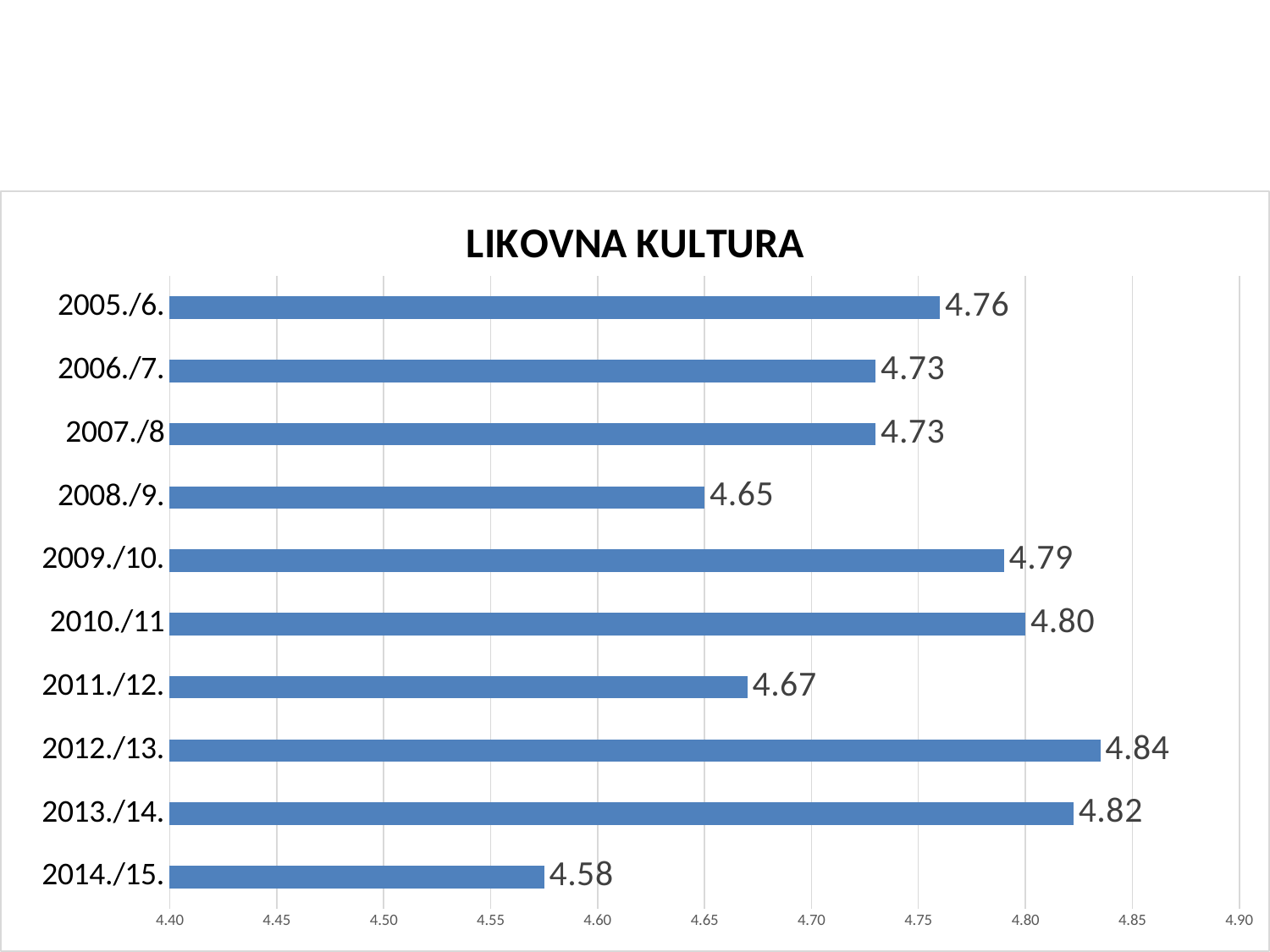
Which school year has the lowest value? 2014./15. What kind of chart is shown on the slide? bar chart How many school years are shown in the chart? 10 What is the value for 2005./6.? 4.76 What is the title of the chart? LIKOVNA KULTURA Is the value for 2009./10. greater or less than 4.70? greater What is the value for 2010./11? 4.80 What is the difference between the values for 2013./14. and 2008./9.? 0.17 What is the value for 2014./15.? 4.58 Which is larger, the value for 2008./9. or the value for 2011./12.? 2011./12. Which school year has the highest value? 2012./13. What is the difference between the values for 2012./13. and 2014./15.? 0.26